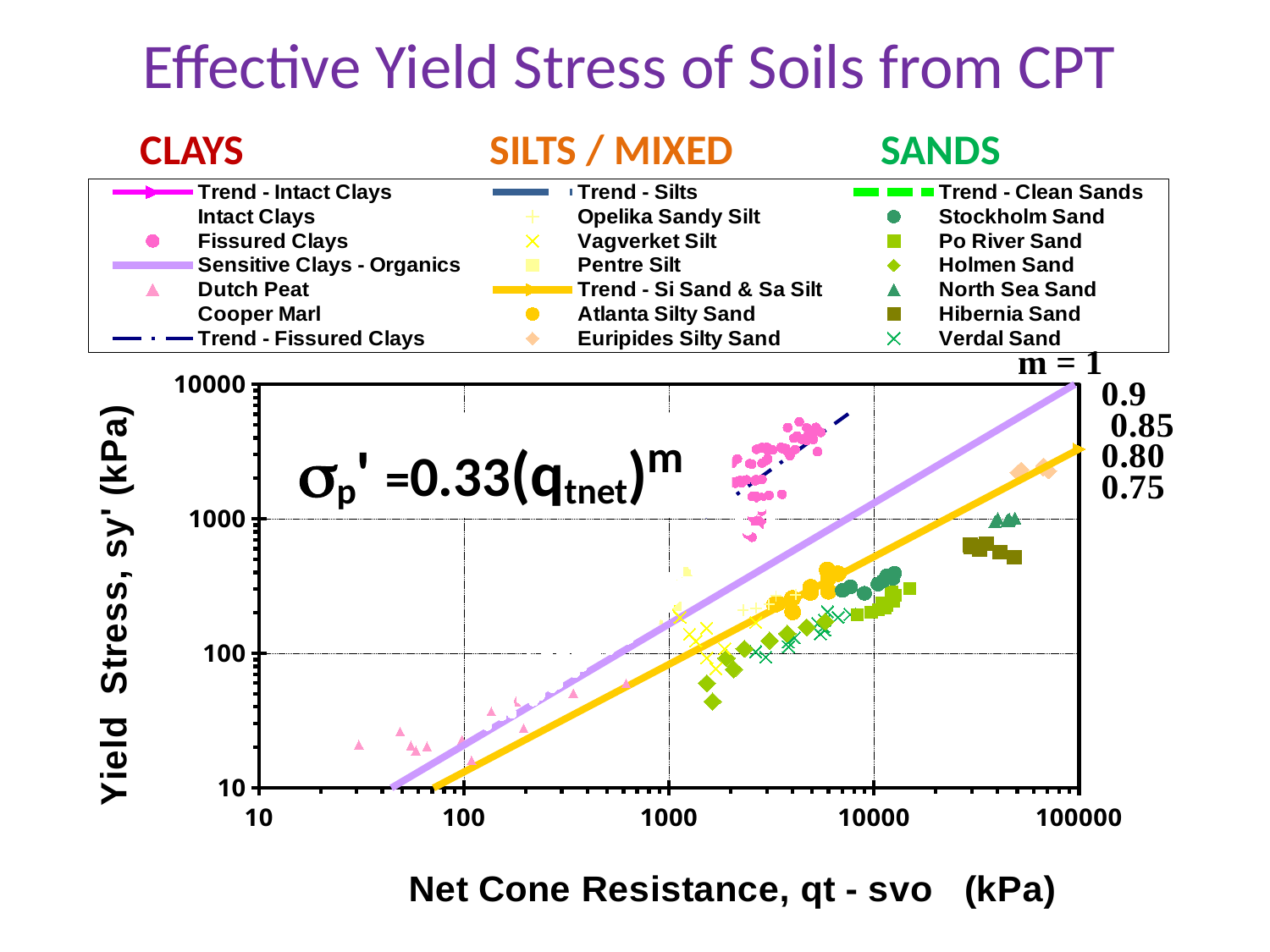
Are the Hibernia Sand net cone resistance values greater or less than 10000 kPa? greater Does yield stress rise or fall as net cone resistance increases along the trend lines? rises Are the Hibernia Sand yield stress values greater or less than 1000 kPa? less Which trend line lies higher on the chart, Sensitive Clays - Organics or Trend - Si Sand & Sa Silt? Sensitive Clays - Organics Are the Dutch Peat yield stress values greater or less than 100 kPa? less How many entries does the legend list under the SANDS group? 7 What is the title of the slide's chart? Effective Yield Stress of Soils from CPT How many entries does the legend list in total across the CLAYS, SILTS / MIXED and SANDS groups? 21 What is the label of the x axis? Net Cone Resistance, qt - svo (kPa) How many values of the exponent m are labelled at the right edge of the chart? 5 What kind of chart is shown on the slide? Scatter plot